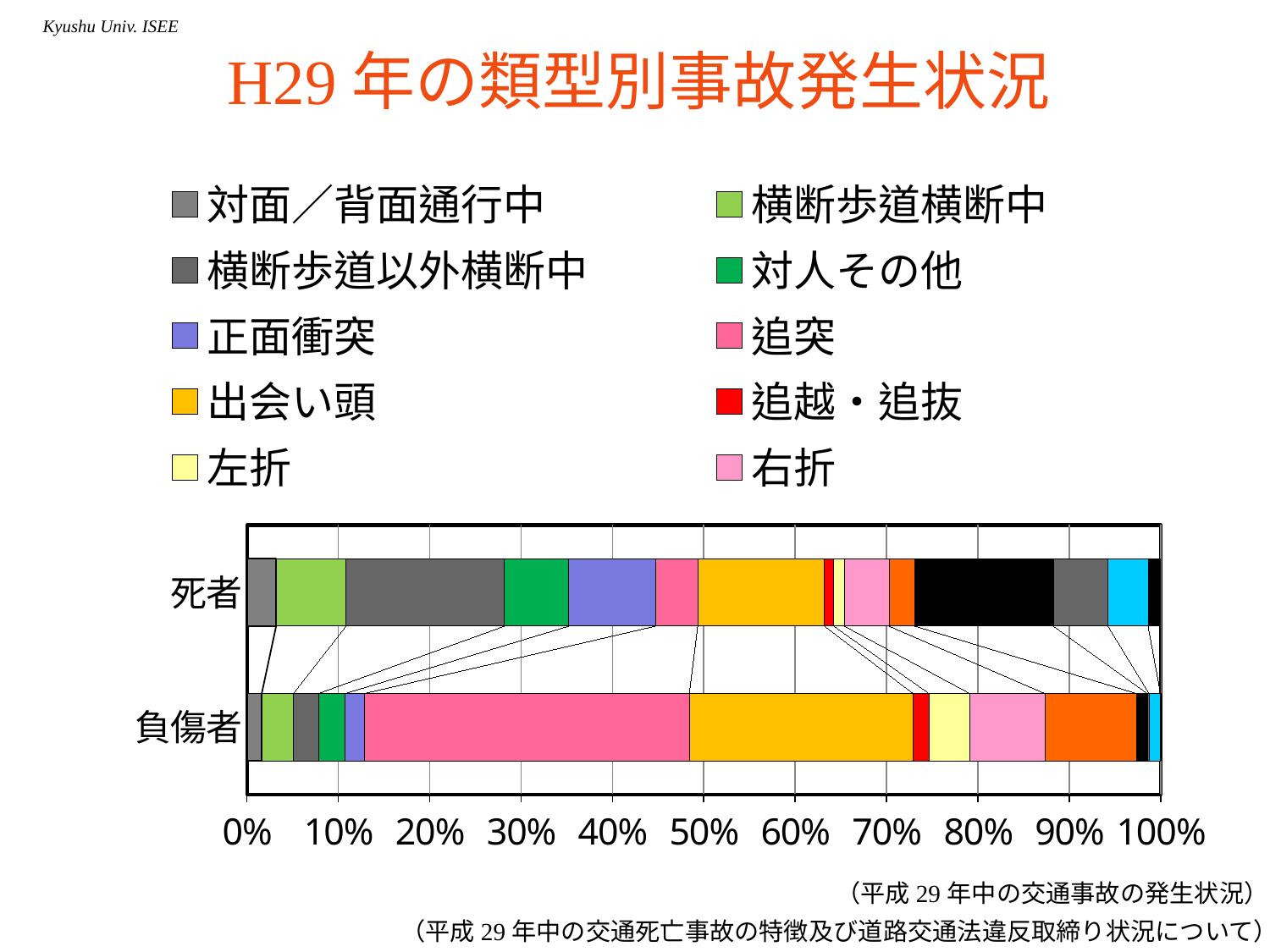
In the 負傷者 bar, is the share for 出会い頭 greater or less than 20%? greater In the 死者 bar, is the share for 追突 greater or less than 10%? less How many series does the legend list? 10 In the 死者 bar, is the share for 横断歩道以外横断中 greater or less than 10%? greater What kind of chart is shown on the slide? Stacked bar chart Is the share of 横断歩道以外横断中 larger in the 死者 bar or the 負傷者 bar? 死者 Which legend category has the largest segment in the 負傷者 bar? 追突 What is the title of the slide's chart? H29 年の類型別事故発生状況 Is the share of 追突 larger in the 死者 bar or the 負傷者 bar? 負傷者 How many bars (categories) does the chart show? 2 What are the two categories on the vertical axis of the chart? 死者 and 負傷者